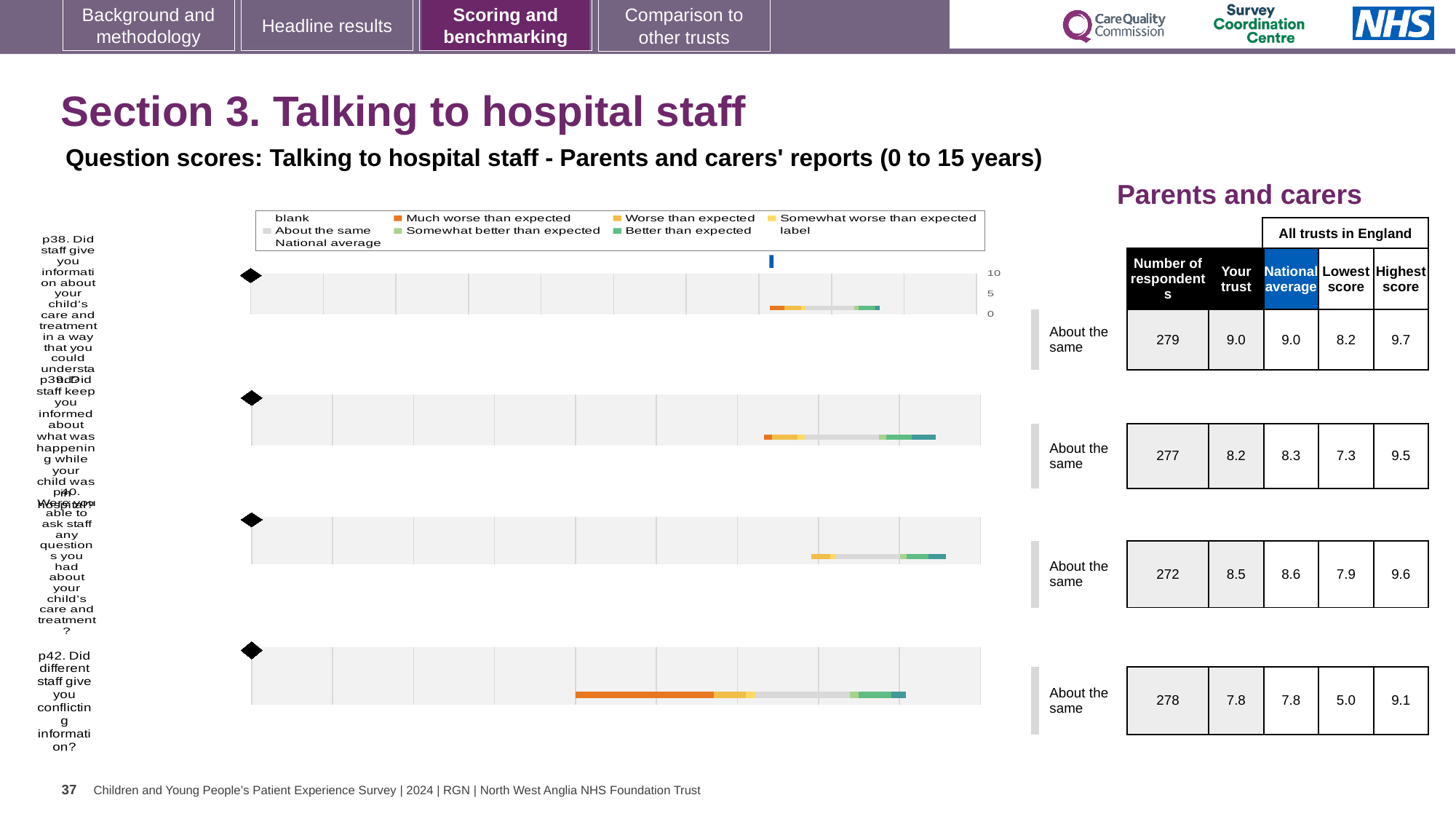
What is the national average score for p40 (Were you able to ask staff any questions you had about your child's care and treatment)? 8.6 Which question has the lowest 'Your trust' score? p42 Which has the larger 'Your trust' score, p39 or p40? p40 For p42, what is the difference between the highest score and the lowest score across all trusts in England? 4.1 Which question has the highest 'Your trust' score? p38 How many respondents answered p42 (Did different staff give you conflicting information)? 278 What colour does the legend use for 'Much worse than expected'? orange What benchmark category is shown for all four questions on this slide? About the same What kind of chart is used to show the question scores on this slide? bar chart What is the 'Your trust' score for p38 (Did staff give you information about your child's care and treatment in a way that you could understand)? 9.0 How many survey questions (rows) are plotted in the chart? 4 What is the lowest score across all trusts in England for p39? 7.3